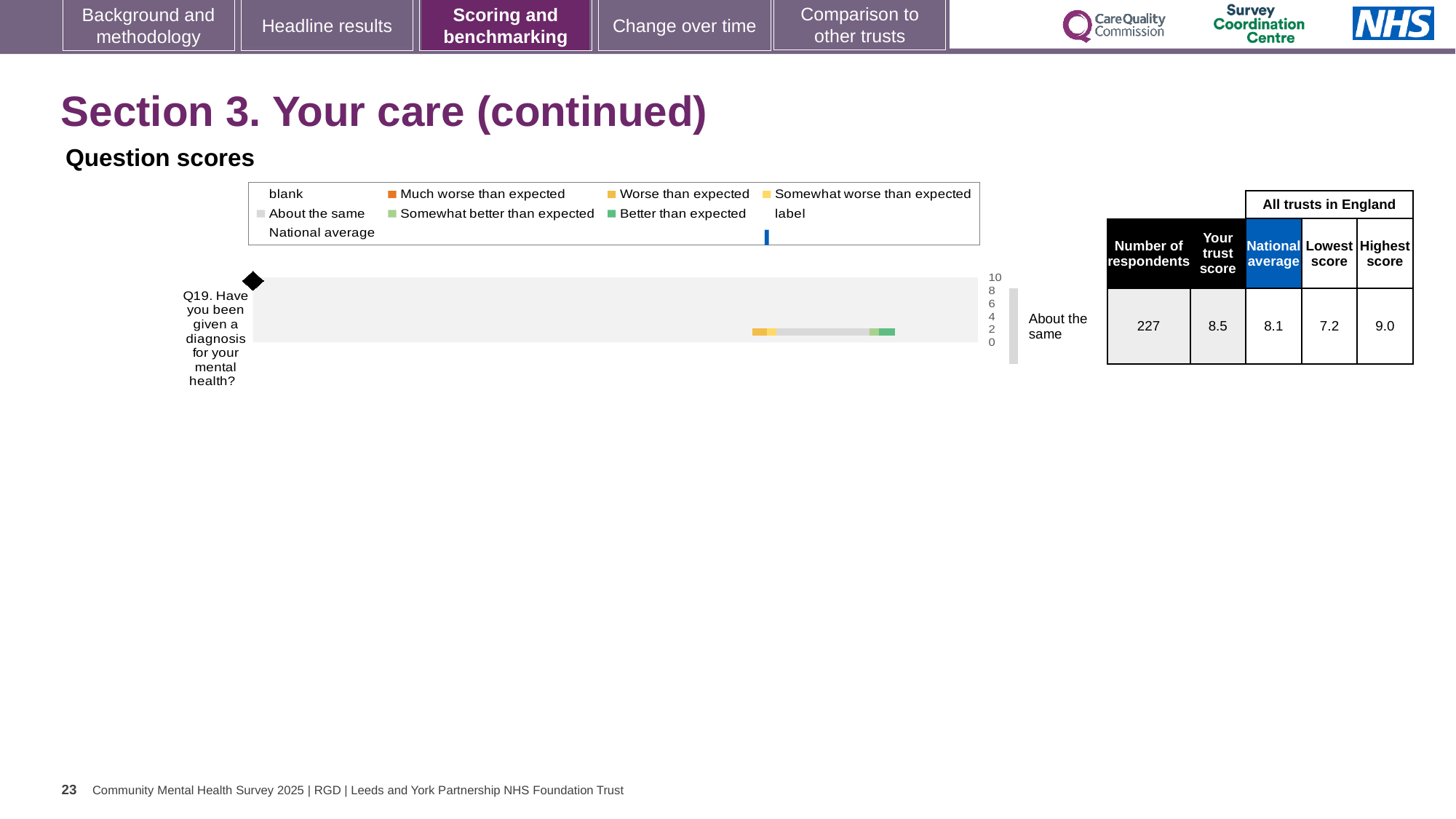
For Q19, which is larger: the trust score or the national average? the trust score How many questions are plotted on the question scores chart? 1 What benchmark category is shown next to the bar for Q19? About the same What is the national average score for Q19? 8.1 What kind of chart is used to show the Q19 question score? bar chart What is the highest score among all trusts in England for Q19? 9.0 What is the highest value shown on the score axis of the chart? 10 Which question is plotted on the question scores chart? Q19. Have you been given a diagnosis for your mental health? What is the number of respondents for Q19? 227 What is the trust score for Q19? 8.5 For Q19, what is the difference between the highest score and the lowest score among all trusts in England? 1.8 What is the lowest score among all trusts in England for Q19? 7.2